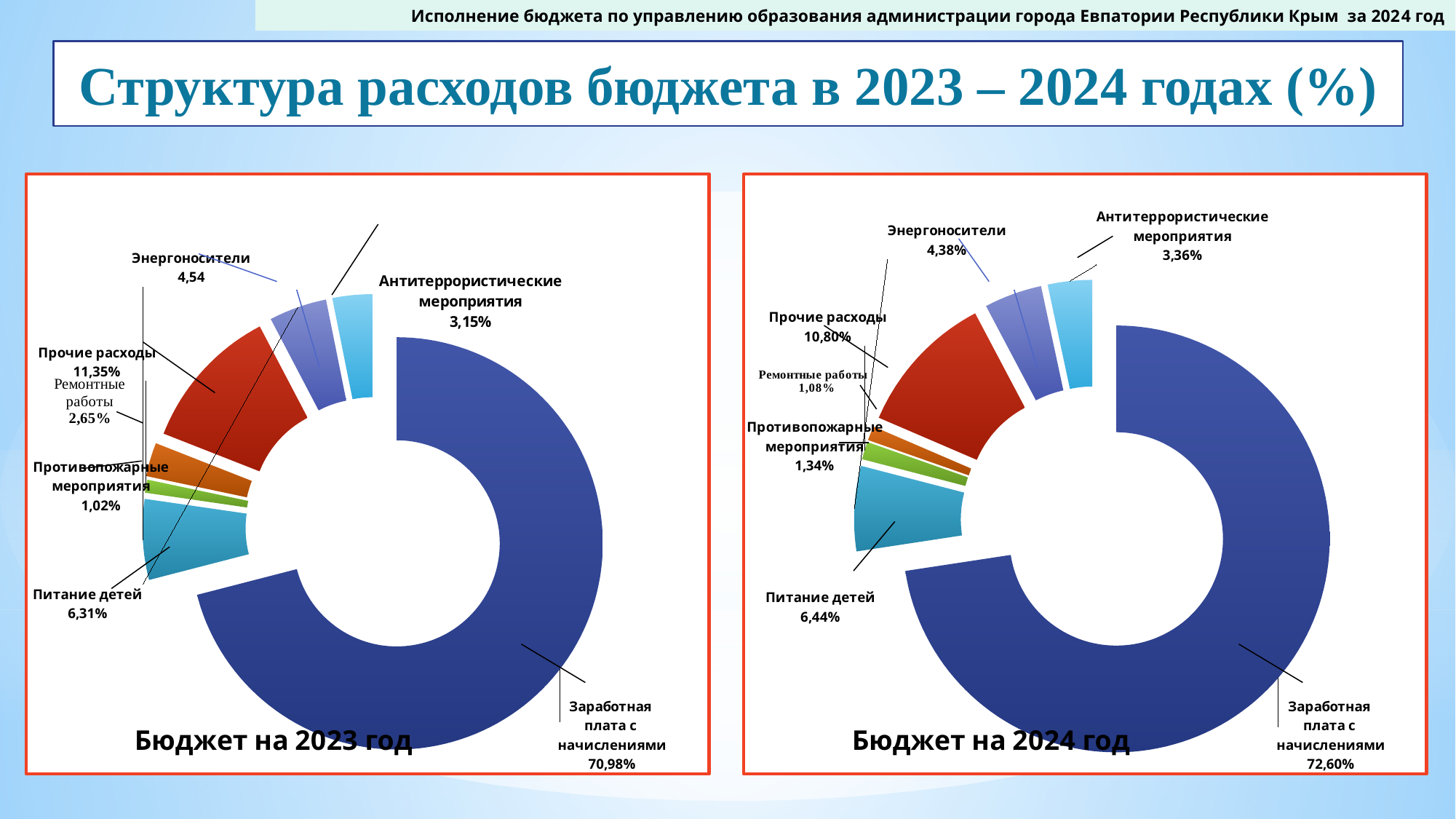
On the 'Бюджет на 2023 год' chart, what is the difference between 'Прочие расходы' and 'Питание детей'? 5,04% On the 'Бюджет на 2023 год' chart, which category has the smallest share? Противопожарные мероприятия On the 'Бюджет на 2024 год' chart, which is larger: 'Питание детей' or 'Энергоносители'? Питание детей On the 'Бюджет на 2024 год' chart, what is the value for 'Ремонтные работы'? 1,08% What is the difference between the 'Заработная плата с начислениями' share on the 'Бюджет на 2024 год' chart and on the 'Бюджет на 2023 год' chart? 1,62% On the 'Бюджет на 2024 год' chart, what is the value for 'Прочие расходы'? 10,80% What is the title of the slide above the two charts? Структура расходов бюджета в 2023 – 2024 годах (%) On the 'Бюджет на 2023 год' chart, what is the value for 'Энергоносители'? 4,54 On the 'Бюджет на 2024 год' chart, which category has the largest share? Заработная плата с начислениями What kind of chart is 'Бюджет на 2024 год'? Pie (doughnut) chart How many categories are shown on the 'Бюджет на 2023 год' chart? 7 On the 'Бюджет на 2023 год' chart, what is the value for 'Заработная плата с начислениями'? 70,98%